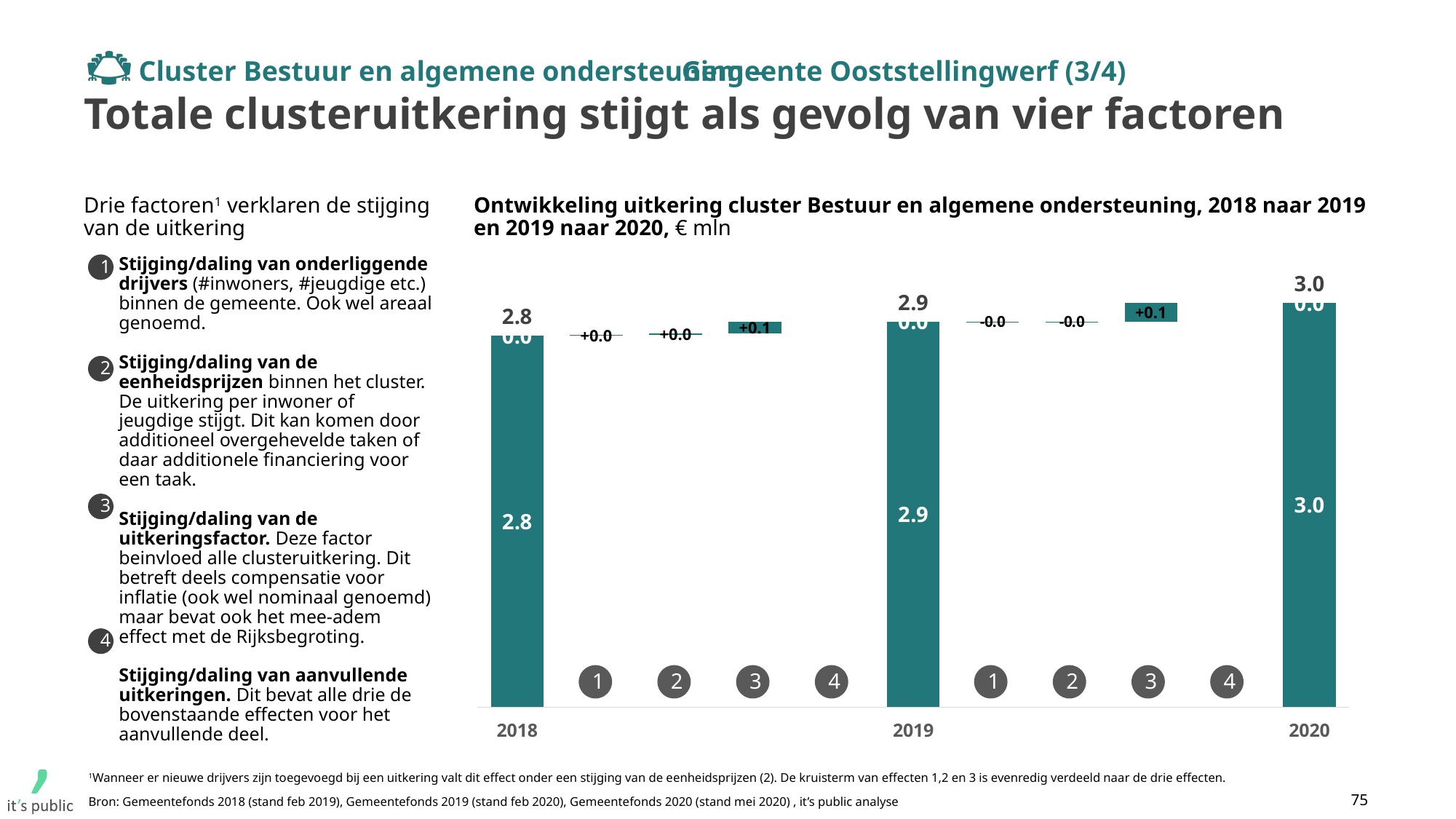
Is the total for 2019 larger or smaller than the total for 2018? larger What is the effect of factor 1 between 2018 and 2019? +0.0 What is the total uitkering shown for 2018? 2.8 What is the total uitkering shown for 2020? 3.0 What is the effect of factor 3 between 2019 and 2020? +0.1 Which year has the lowest total uitkering? 2018 Which year has the highest total uitkering? 2020 What is the effect of factor 3 between 2018 and 2019? +0.1 Do the total values rise or fall from 2018 to 2020? rise What is the difference between the 2020 total and the 2018 total? 0.2 What is the total uitkering shown for 2019? 2.9 In what unit are the values in the chart expressed? € mln